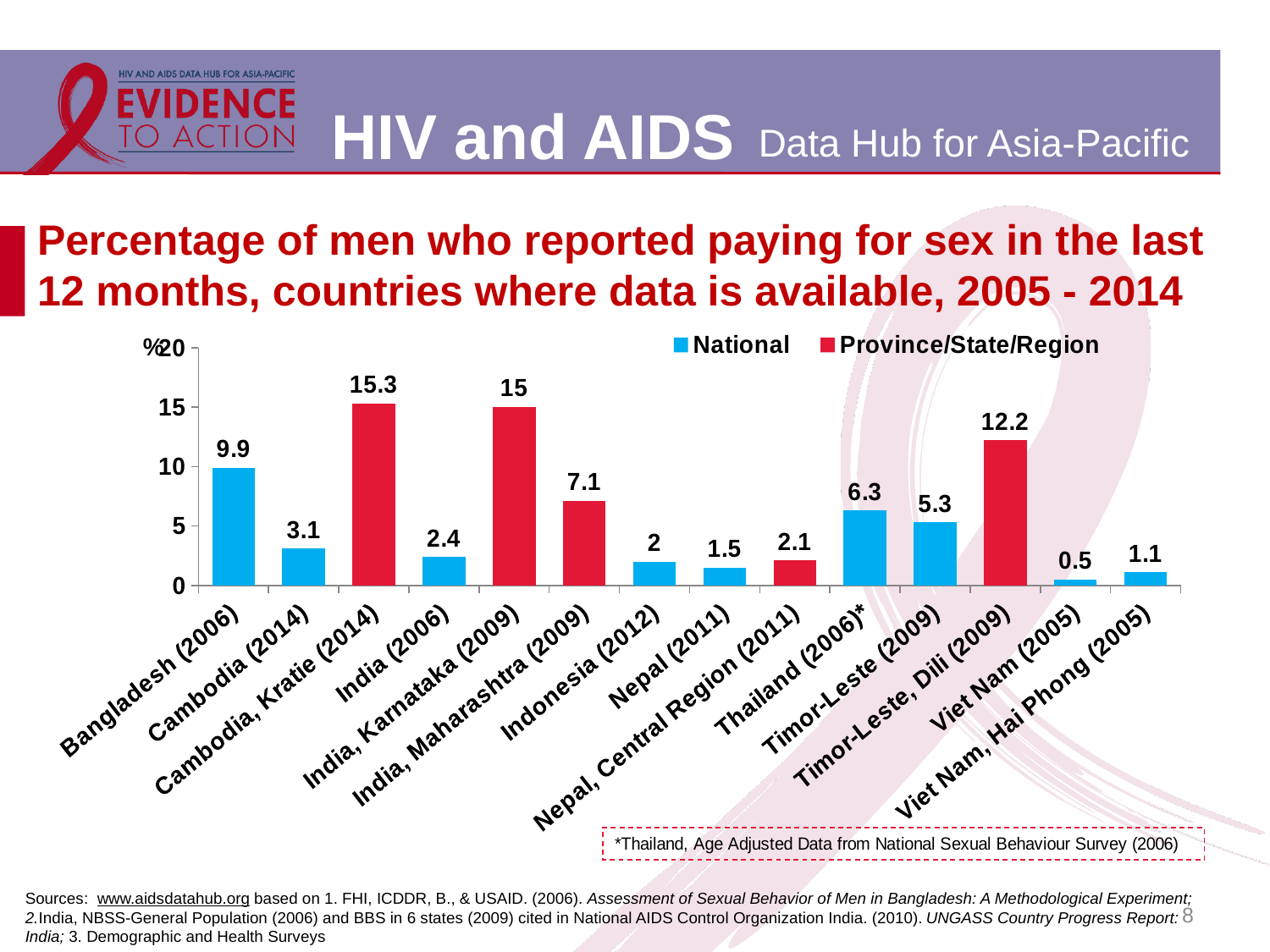
Which category has the lowest value? Viet Nam (2005) What is the value for Bangladesh (2006)? 9.9 What kind of chart is shown on the slide? bar chart Which is larger, the value for Cambodia (2014) or the value for Timor-Leste (2009)? Timor-Leste (2009) Is the value for India, Maharashtra (2009) greater or less than 5? greater What is the difference between the values for India, Karnataka (2009) and India (2006)? 12.6 What is the value for Timor-Leste, Dili (2009)? 12.2 What is the value for Thailand (2006)*? 6.3 How many series does the legend list? 2 How many categories are shown on the x axis? 14 Which category has the highest value? Cambodia, Kratie (2014) Which series is shown in red? Province/State/Region